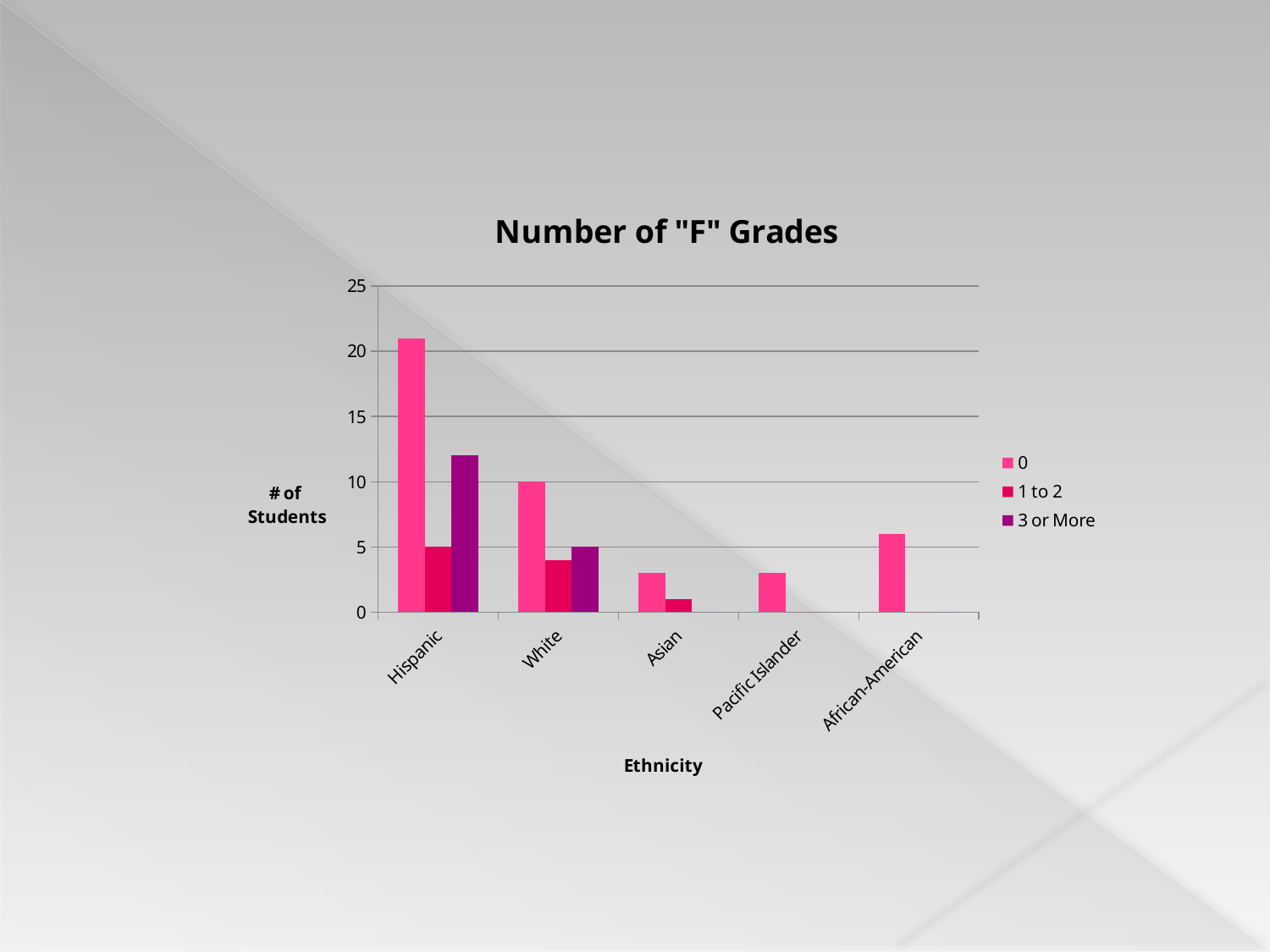
Which ethnicity has the highest value in the "0" series? Hispanic Is the value of the "0" series for Hispanic greater or less than 20? greater Is the value of the "3 or More" series for Hispanic greater or less than 10? greater What is the difference between the "0" value and the "3 or More" value for White? 5 What is the value of the "1 to 2" series for Hispanic? 5 What is the value of the "0" series for White? 10 What is the title of the x axis? Ethnicity How many ethnicity categories are shown on the x axis? 5 Which is larger: the "3 or More" value for Hispanic or the "3 or More" value for White? Hispanic What is the value of the "3 or More" series for White? 5 What kind of chart is shown on the slide? bar chart How many series does the legend list? 3